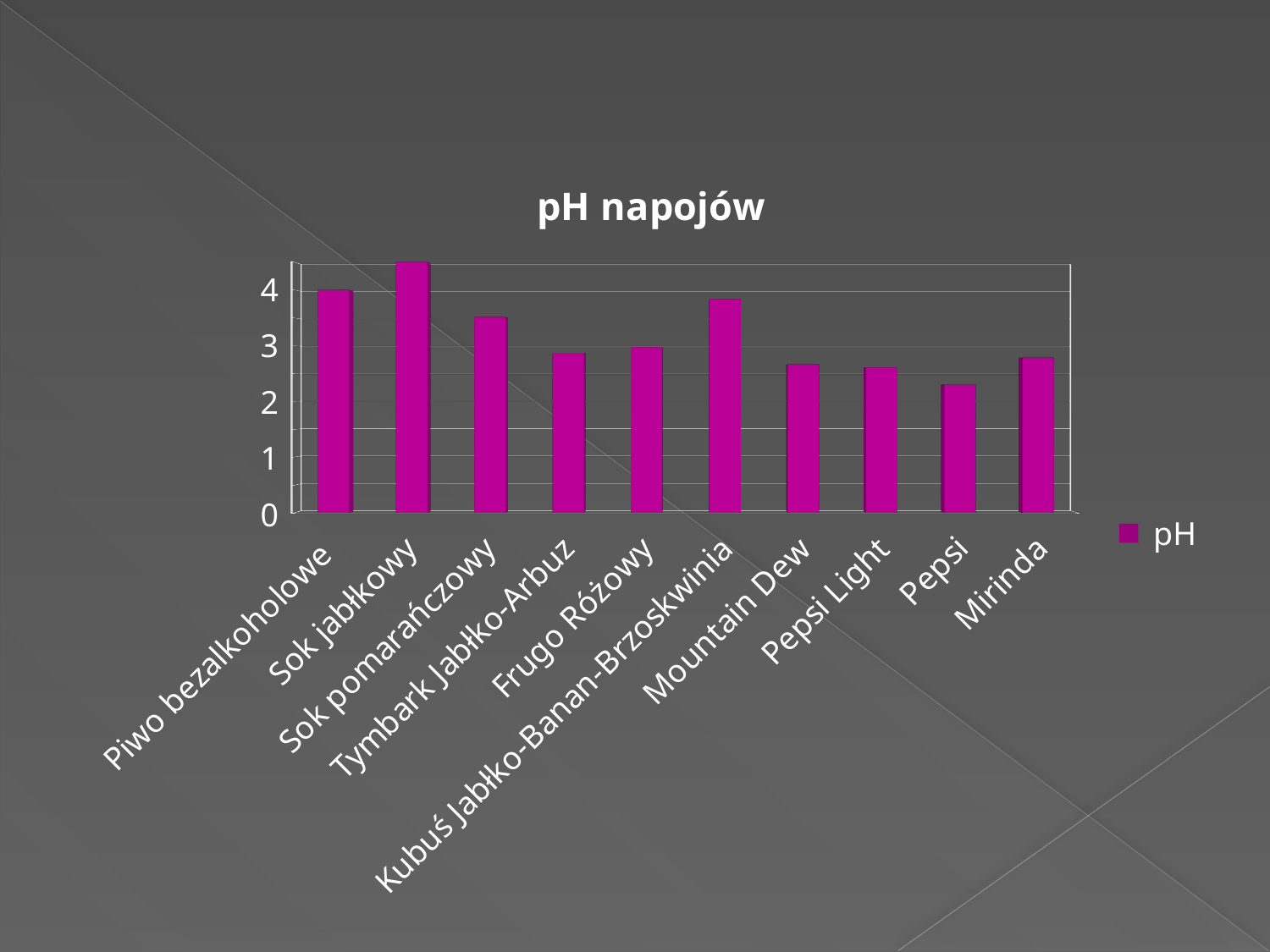
Which has a higher pH, Kubuś Jabłko-Banan-Brzoskwinia or Mountain Dew? Kubuś Jabłko-Banan-Brzoskwinia Is the pH value for Mountain Dew greater or less than 3? less Which drink has the highest pH in the chart? Sok jabłkowy Is the pH value for Sok jabłkowy greater or less than 4? greater Which drink has the lowest pH in the chart? Pepsi What is the title of the chart? pH napojów How many series does the chart's legend list? 1 Is the pH value for Sok pomarańczowy greater or less than 3? greater What kind of chart is shown on the slide? bar chart How many drinks (categories) are shown on the x axis of the chart? 10 What is the name of the series shown in the chart's legend? pH